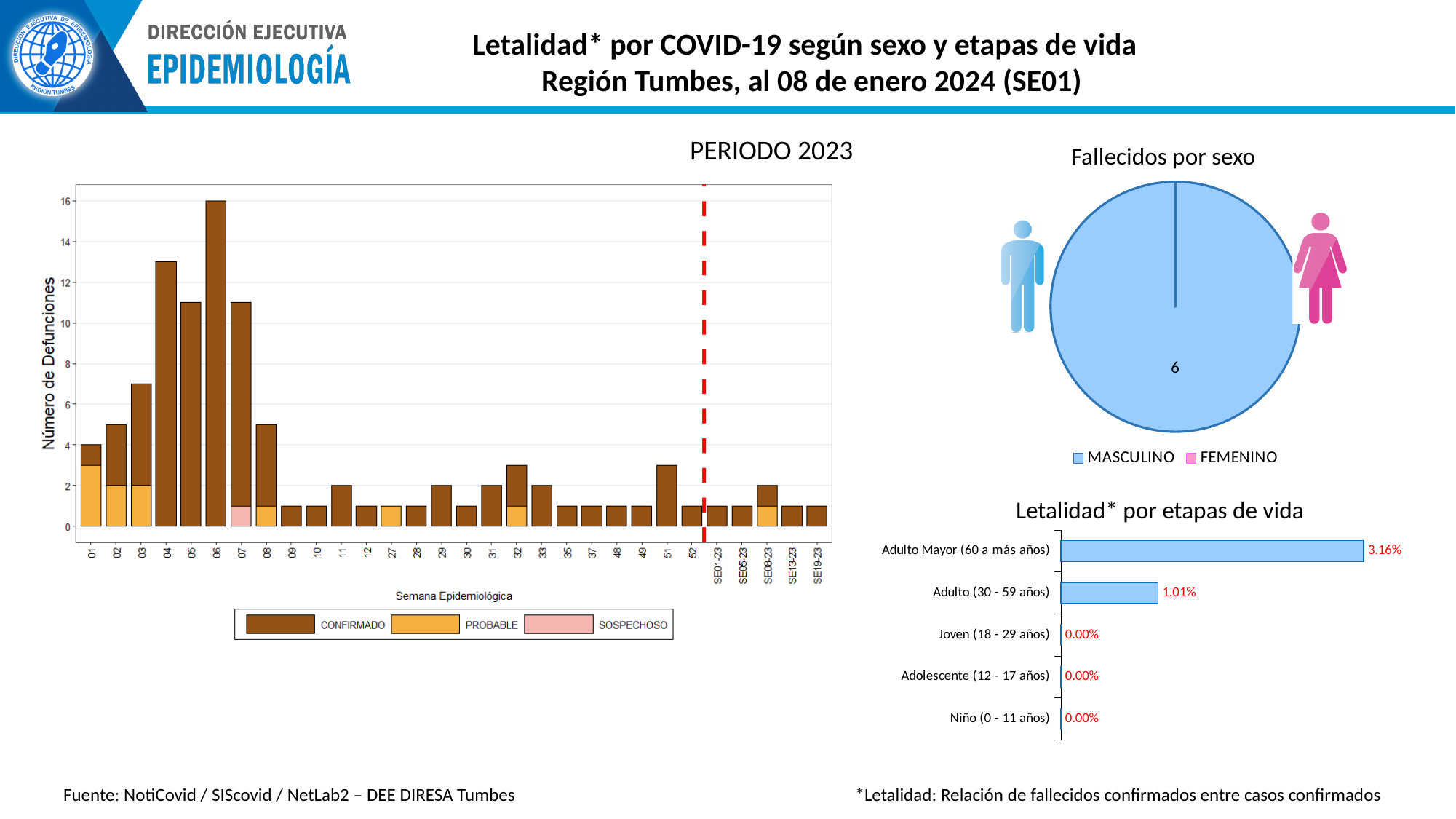
In the 'Letalidad* por etapas de vida' chart, how many age groups are shown? 5 In the 'Letalidad* por etapas de vida' chart, which age group has the highest value? Adulto Mayor (60 a más años) How many entries does the legend of the 'Número de Defunciones' bar chart on the left list? 3 In the 'Letalidad* por etapas de vida' chart, what is the value for Adulto Mayor (60 a más años)? 3.16% What kind of chart is 'Letalidad* por etapas de vida'? bar chart How many entries does the legend of the 'Fallecidos por sexo' chart list? 2 In the 'Letalidad* por etapas de vida' chart, what is the value for Adulto (30 - 59 años)? 1.01% In the 'Número de Defunciones' bar chart on the left, is the total for week 04 greater or less than 12? greater What kind of chart is 'Fallecidos por sexo'? pie chart In the 'Número de Defunciones' bar chart on the left, which epidemiological week has the highest number of deaths? 06 In the 'Fallecidos por sexo' chart, what value is shown for MASCULINO? 6 In the 'Letalidad* por etapas de vida' chart, what is the difference between the values for Adulto Mayor (60 a más años) and Adulto (30 - 59 años)? 2.15%